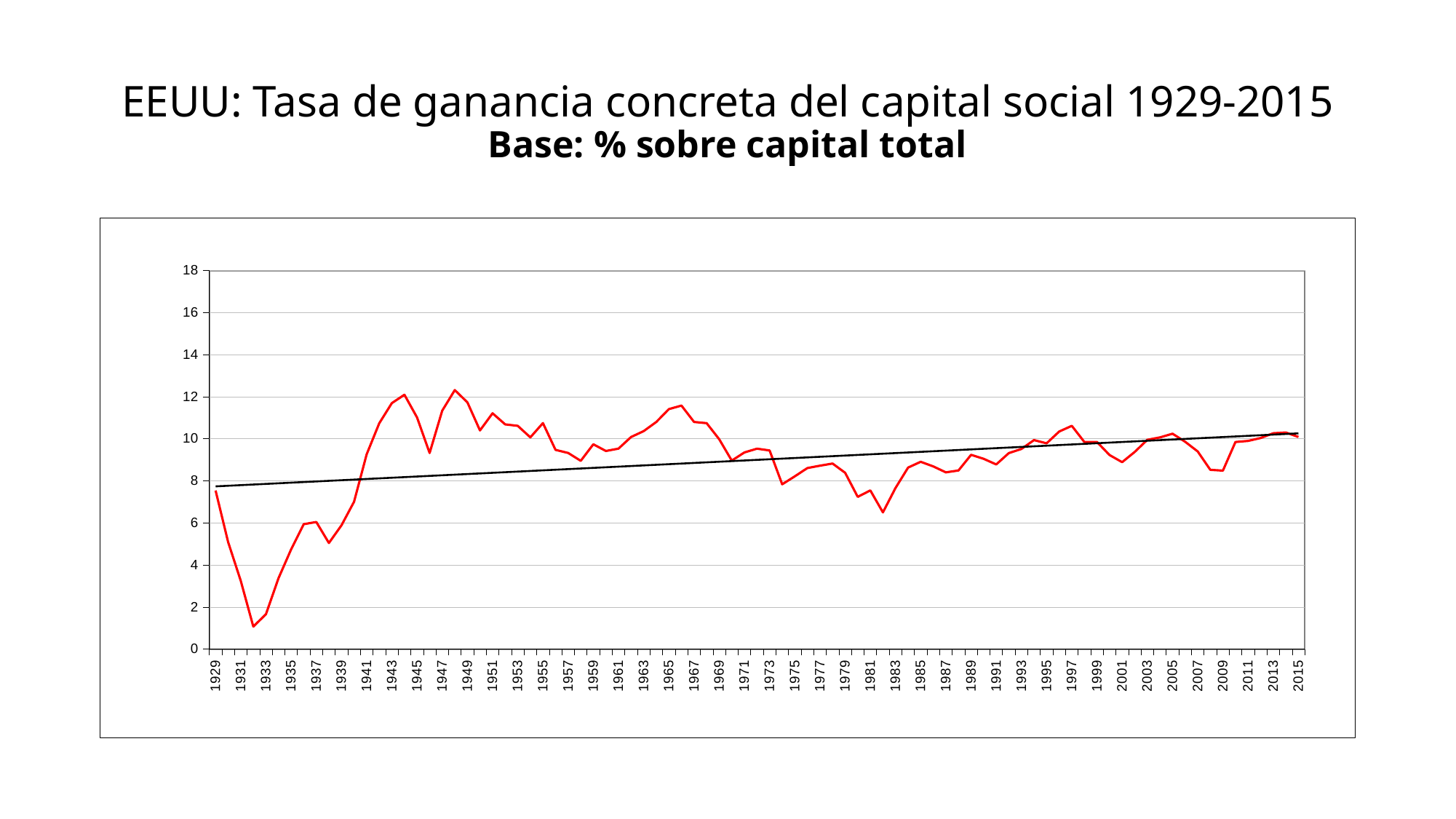
Is the value for 2009 greater or less than 10? less Does the black straight trend line rise or fall from 1929 to 2015? rises Is the value for 1982 greater or less than 8? less What is the title of the chart on the slide? EEUU: Tasa de ganancia concreta del capital social 1929-2015 Is the value for 1966 greater or less than 10? greater What is the highest value shown on the vertical axis? 18 What kind of chart is shown on the slide? line chart In which year does the red line reach its lowest value? 1932